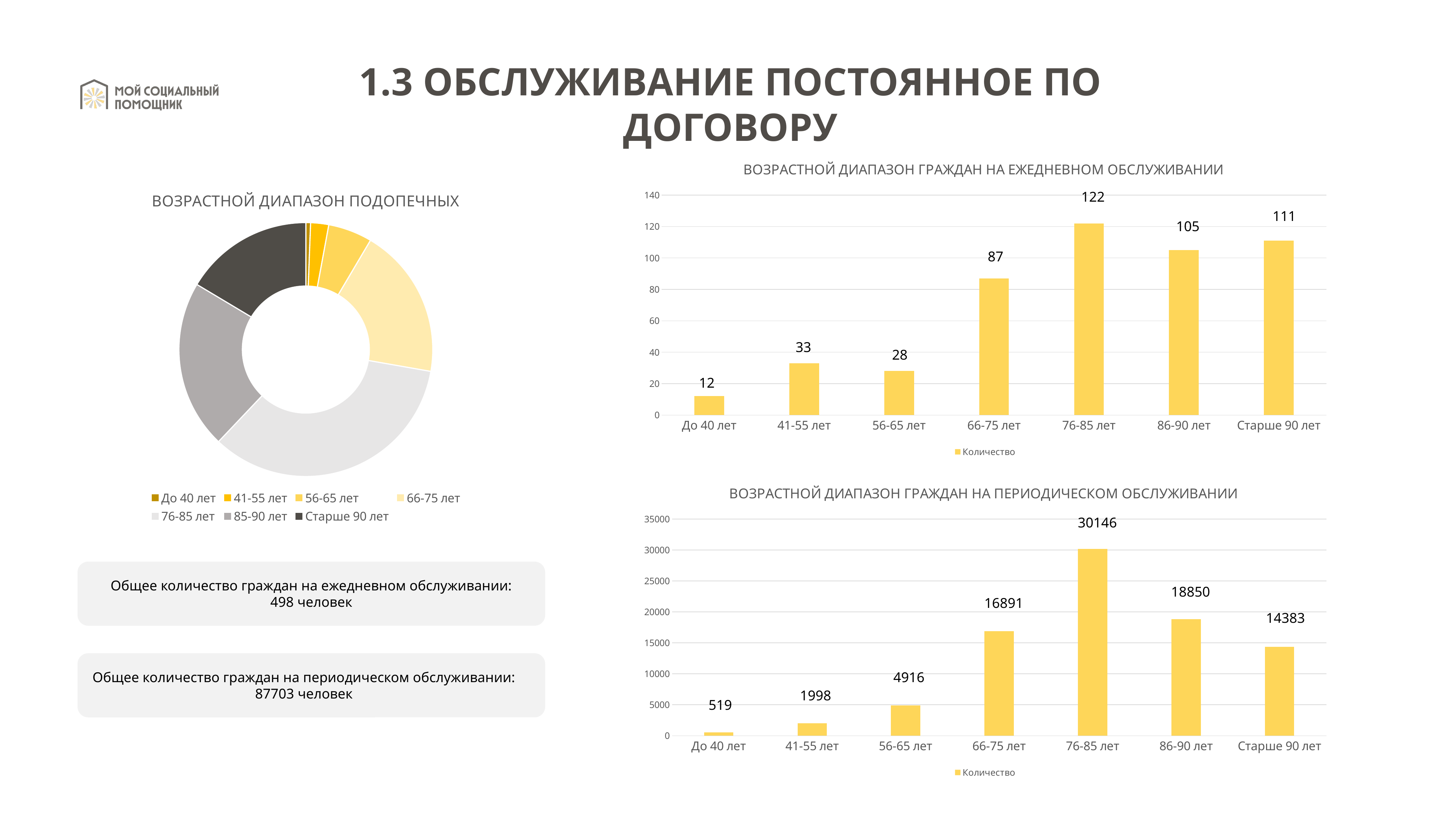
In the chart titled "ВОЗРАСТНОЙ ДИАПАЗОН ГРАЖДАН НА ЕЖЕДНЕВНОМ ОБСЛУЖИВАНИИ", what is the value for 66-75 лет? 87 In the chart titled "ВОЗРАСТНОЙ ДИАПАЗОН ГРАЖДАН НА ПЕРИОДИЧЕСКОМ ОБСЛУЖИВАНИИ", what is the difference between the values for 66-75 лет and 56-65 лет? 11975 In the chart titled "ВОЗРАСТНОЙ ДИАПАЗОН ГРАЖДАН НА ПЕРИОДИЧЕСКОМ ОБСЛУЖИВАНИИ", what is the value for 86-90 лет? 18850 In the chart titled "ВОЗРАСТНОЙ ДИАПАЗОН ГРАЖДАН НА ЕЖЕДНЕВНОМ ОБСЛУЖИВАНИИ", which is larger: the value for 41-55 лет or 56-65 лет? 41-55 лет In the chart titled "ВОЗРАСТНОЙ ДИАПАЗОН ГРАЖДАН НА ЕЖЕДНЕВНОМ ОБСЛУЖИВАНИИ", which age category has the lowest value? До 40 лет In the chart titled "ВОЗРАСТНОЙ ДИАПАЗОН ГРАЖДАН НА ЕЖЕДНЕВНОМ ОБСЛУЖИВАНИИ", how many age categories are shown on the x axis? 7 In the chart titled "ВОЗРАСТНОЙ ДИАПАЗОН ГРАЖДАН НА ПЕРИОДИЧЕСКОМ ОБСЛУЖИВАНИИ", what is the value for До 40 лет? 519 What kind of chart is the one titled "ВОЗРАСТНОЙ ДИАПАЗОН ПОДОПЕЧНЫХ"? Doughnut chart In the chart titled "ВОЗРАСТНОЙ ДИАПАЗОН ГРАЖДАН НА ПЕРИОДИЧЕСКОМ ОБСЛУЖИВАНИИ", which age category has the highest value? 76-85 лет How many series does the legend of the chart titled "ВОЗРАСТНОЙ ДИАПАЗОН ГРАЖДАН НА ПЕРИОДИЧЕСКОМ ОБСЛУЖИВАНИИ" list? 1 In the chart titled "ВОЗРАСТНОЙ ДИАПАЗОН ГРАЖДАН НА ЕЖЕДНЕВНОМ ОБСЛУЖИВАНИИ", which age category has the highest value? 76-85 лет In the chart titled "ВОЗРАСТНОЙ ДИАПАЗОН ГРАЖДАН НА ЕЖЕДНЕВНОМ ОБСЛУЖИВАНИИ", what is the difference between the values for 76-85 лет and 86-90 лет? 17